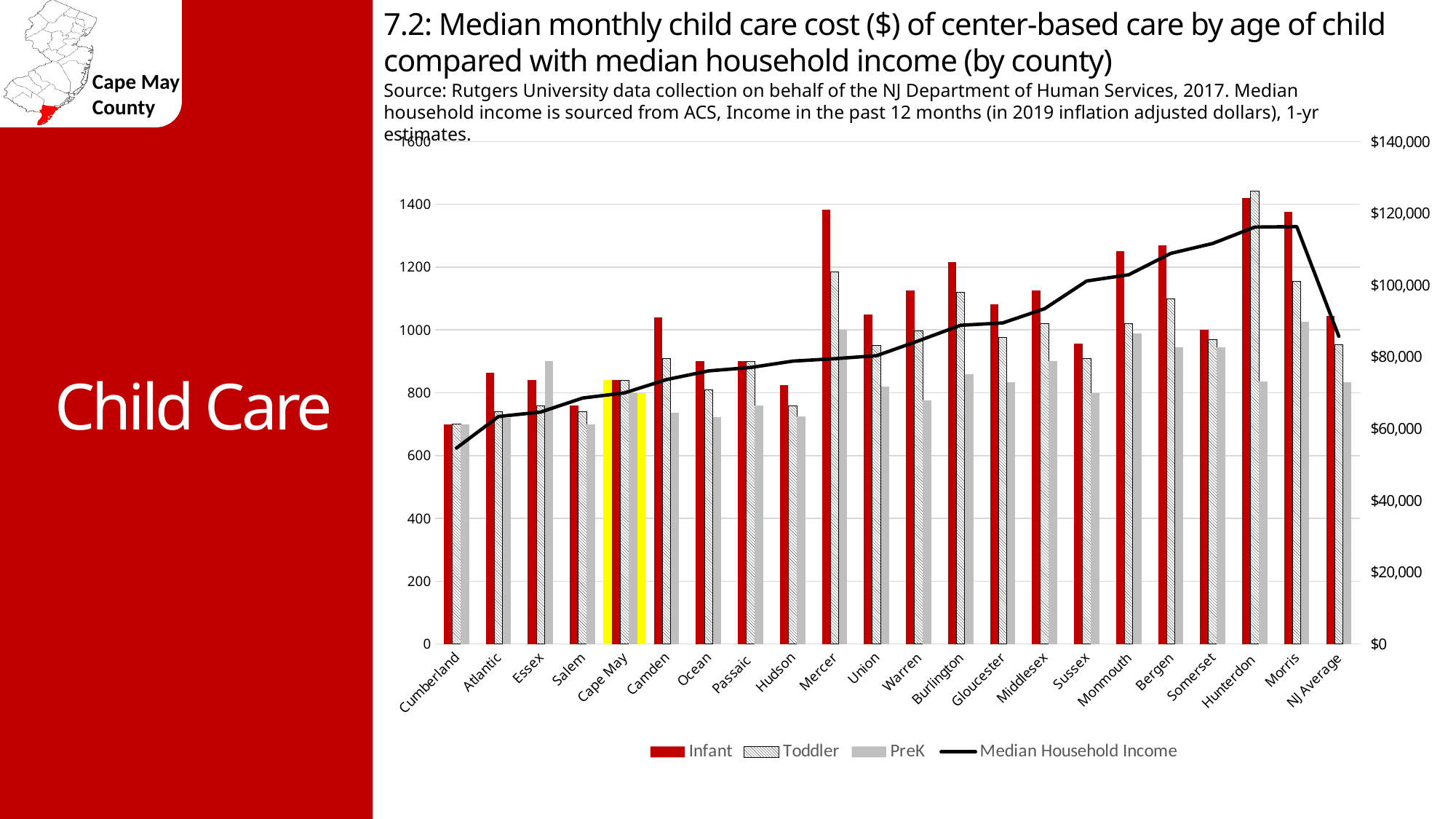
Which county has the highest Toddler cost? Hunterdon Is the Median Household Income for Cumberland greater or less than $60,000? less What kind of chart is this? Bar chart with a line series Is the Infant value for Mercer greater or less than 1200? greater How many series does the legend list? 4 Is the Median Household Income for Morris greater or less than $100,000? greater Which county's bars are highlighted in yellow? Cape May Does the Median Household Income line generally rise or fall from Cumberland to Morris? rise How many counties/categories are shown on the x axis? 22 Which is larger, the Infant cost for Mercer or the Infant cost for Cape May? Mercer Which county has the lowest Infant cost? Cumberland